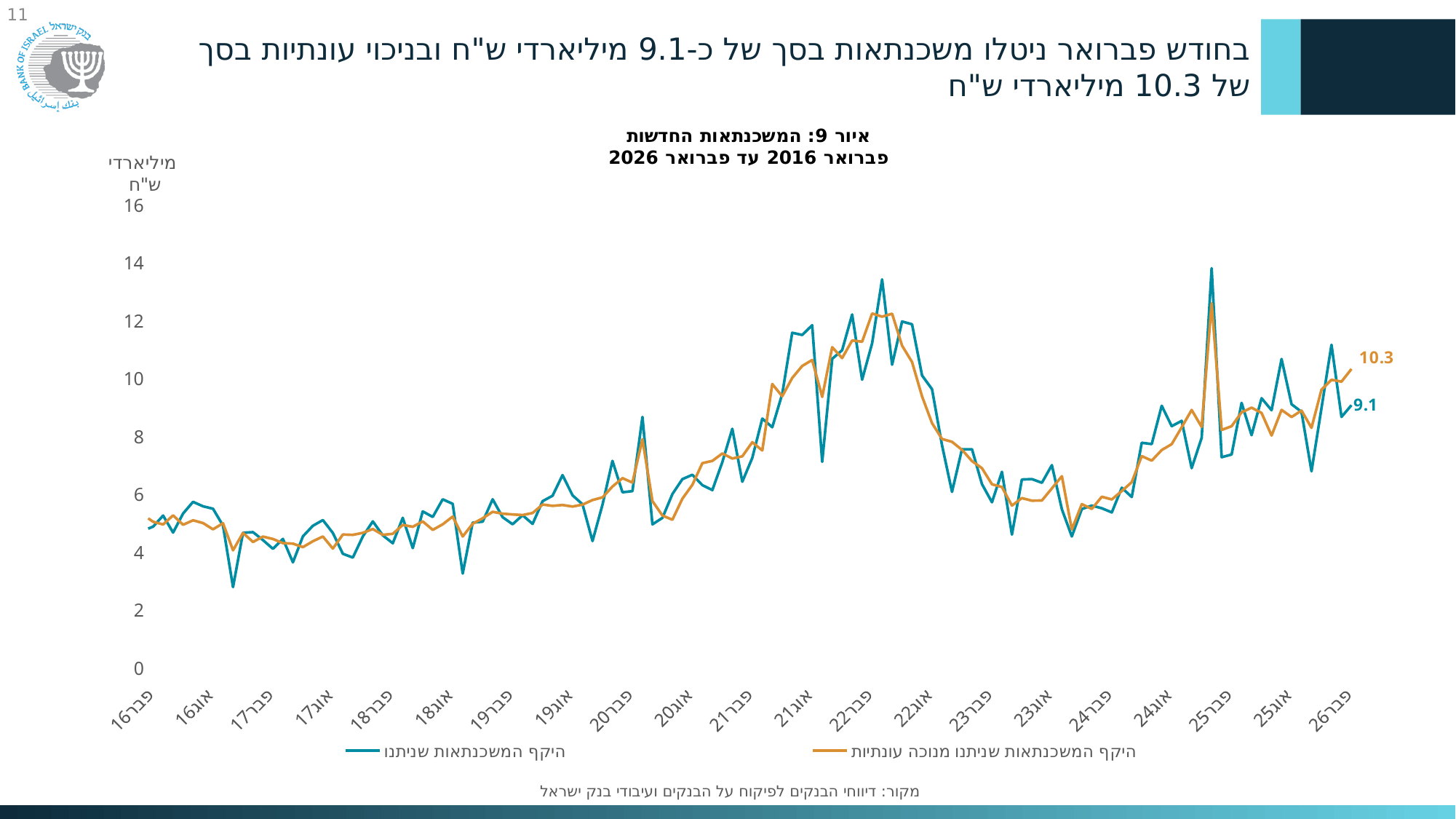
How many series does the legend list? 2 What is the difference between the two labelled values at February 2026 (10.3 and 9.1)? 1.2 Is the value of the unadjusted (teal) series at February 2016 greater or less than 8? less What is the labelled value of the unadjusted series (היקף המשכנתאות שניתנו) at February 2026? 9.1 Is the value of the seasonally adjusted (orange) series around February 2022 greater or less than 10? greater What is the title of the chart? איור 9: המשכנתאות החדשות פברואר 2016 עד פברואר 2026 Is the peak of the unadjusted (teal) series around February 2025 greater or less than 12? greater Do the values generally rise or fall between February 2016 and February 2022? rise What unit is shown on the vertical axis of the chart? מיליארדי ש"ח At February 2026, which series has the higher labelled value: the seasonally adjusted series or the unadjusted series? the seasonally adjusted series (10.3) What kind of chart is shown on the slide? line chart What is the labelled value of the seasonally adjusted series (היקף המשכנתאות שניתנו מנוכה עונתיות) at the end of the chart, February 2026? 10.3